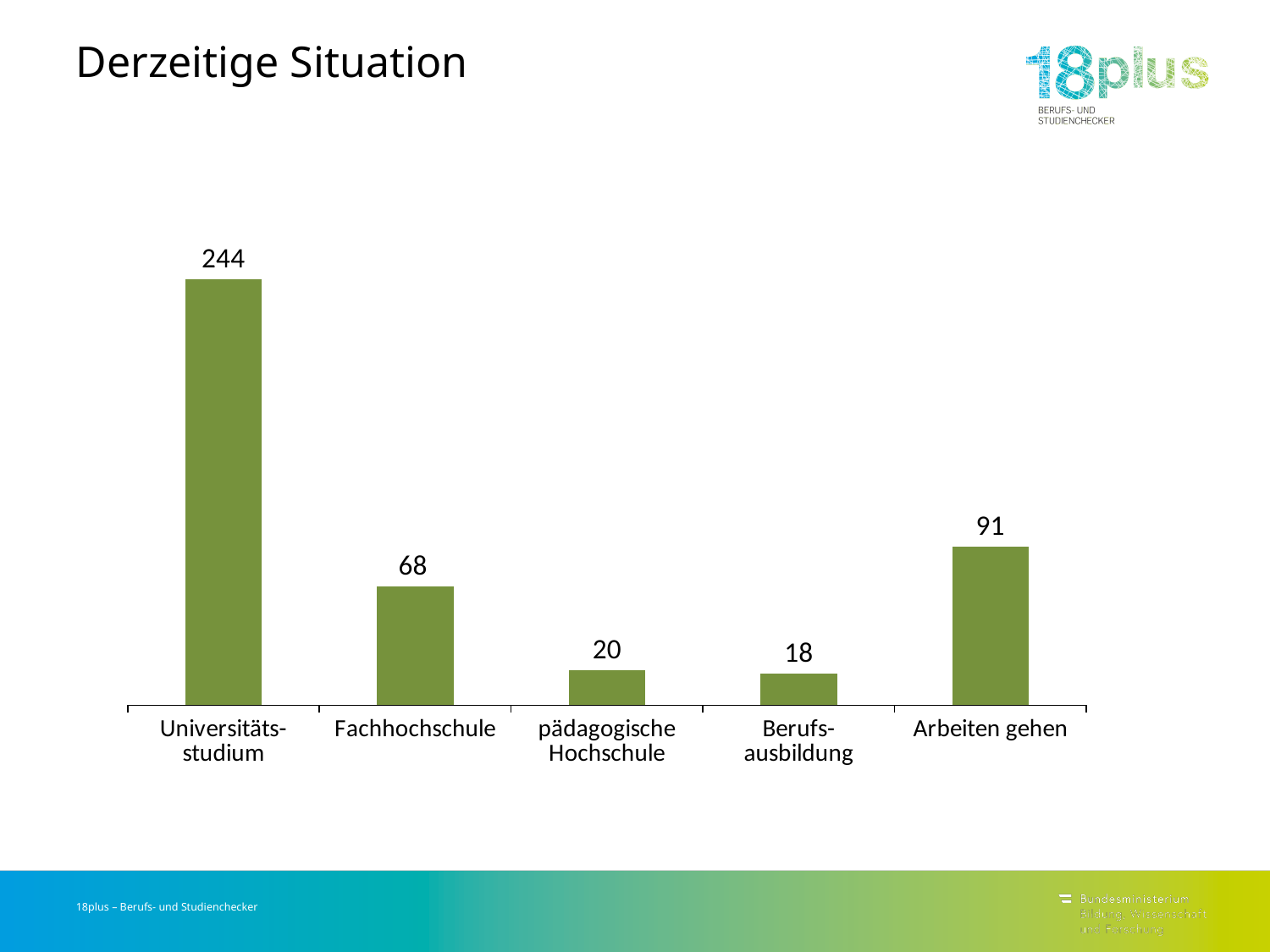
What is the difference between the values for Fachhochschule and pädagogische Hochschule? 48 What is the value for pädagogische Hochschule? 20 What is the difference between the values for Universitätsstudium and Arbeiten gehen? 153 How many categories are shown in the chart? 5 Which category has the highest value? Universitätsstudium Which is larger, the value for Arbeiten gehen or the value for Fachhochschule? Arbeiten gehen What is the value for Berufsausbildung? 18 What is the value for Arbeiten gehen? 91 What is the value for Universitätsstudium? 244 Which category has the lowest value? Berufsausbildung What kind of chart is shown on the slide? Bar chart What is the value for Fachhochschule? 68